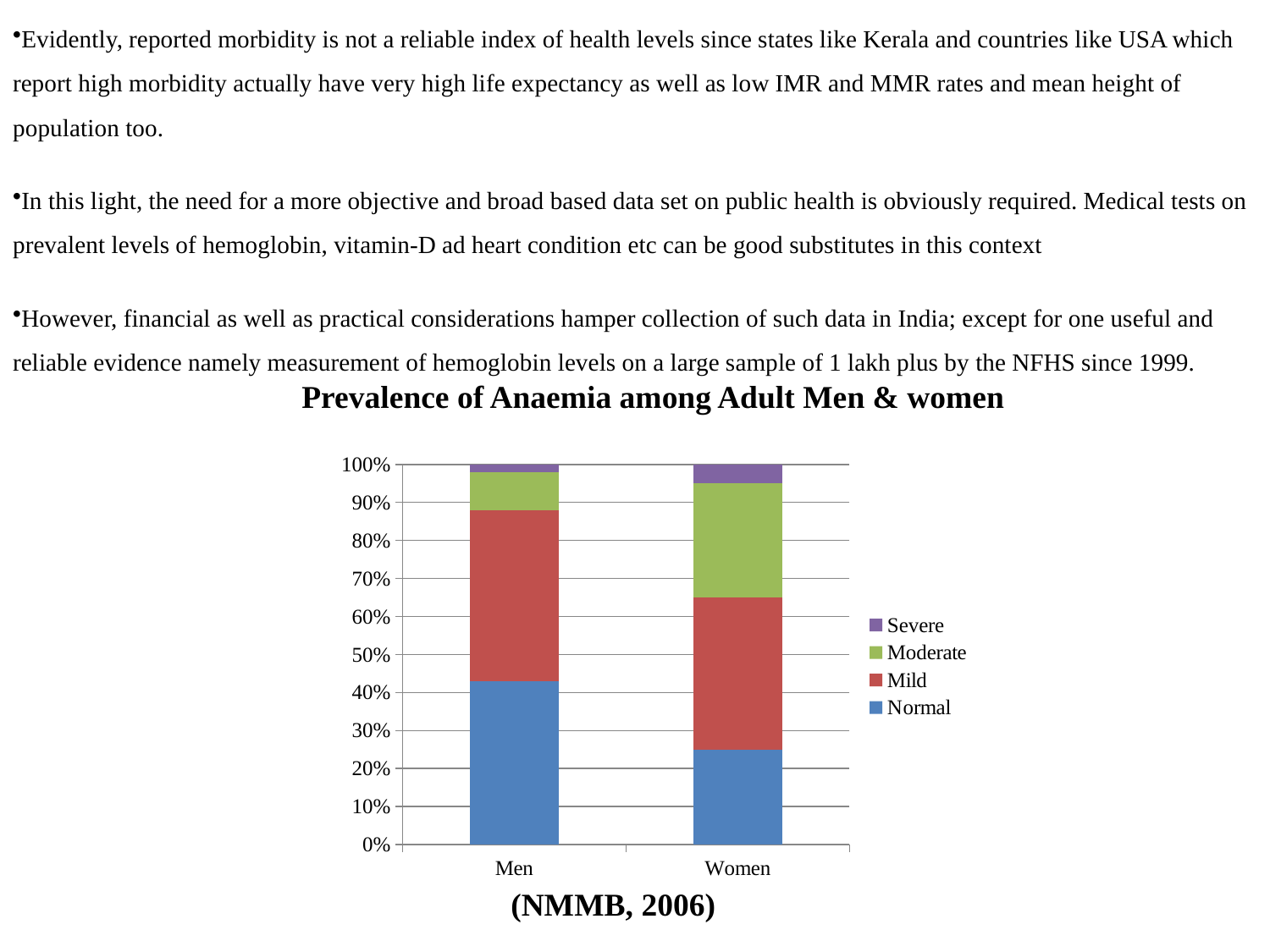
Which category has the larger Normal share, Men or Women? Men What kind of chart is shown on the slide? stacked bar chart What does each stacked bar total? 100% Which category has the larger Moderate share, Men or Women? Women What is the title of the chart? Prevalence of Anaemia among Adult Men & women How many series does the legend list? 4 Which category has the larger Severe share, Men or Women? Women Which series is shown in blue in the legend? Normal Is the Normal share for Women greater or less than 30%? less Is the Normal share for Men greater or less than 50%? less How many categories are shown on the x axis? 2 Is the Normal share for Men greater or less than 40%? greater